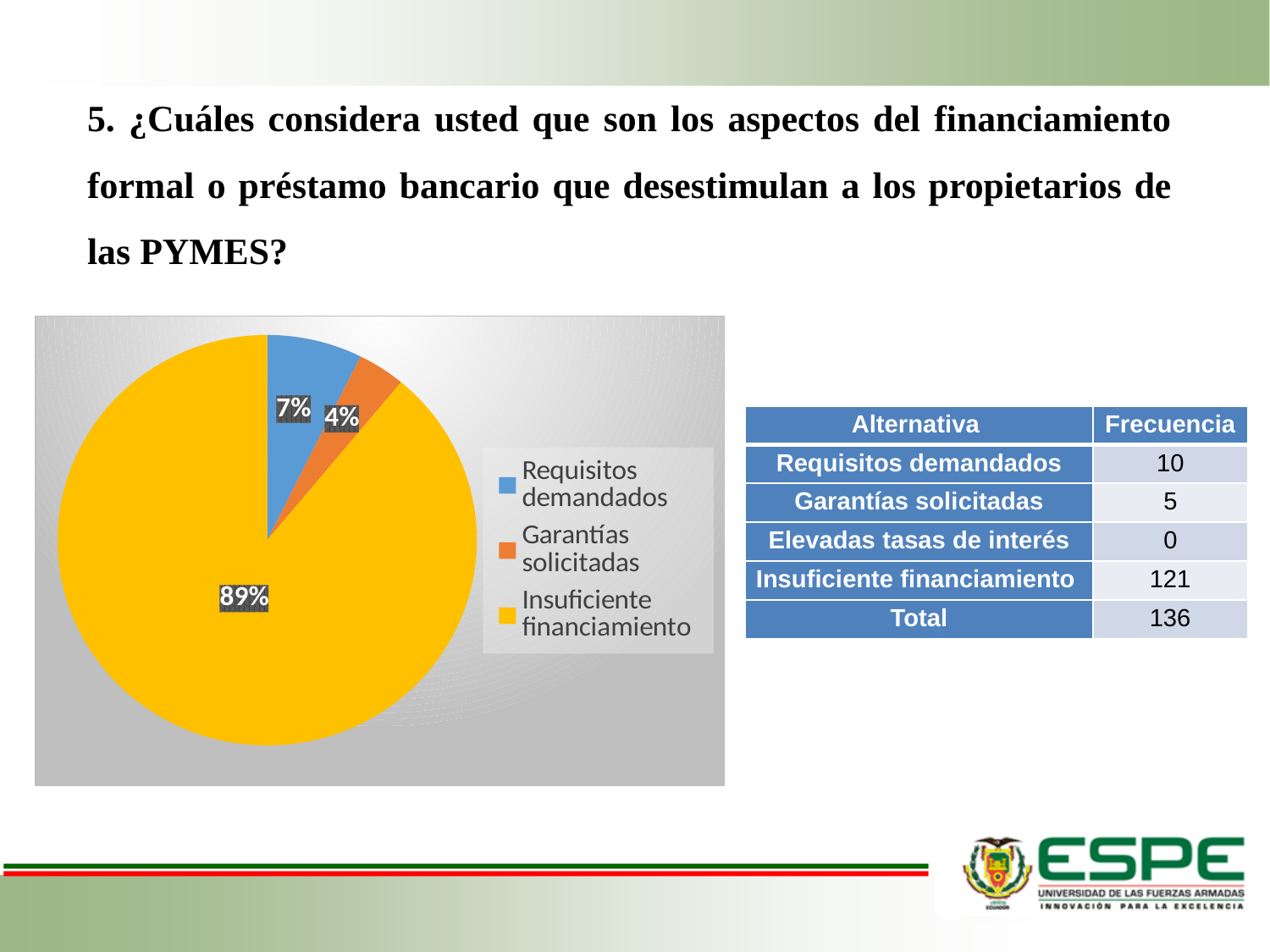
What percentage of the pie chart corresponds to Garantías solicitadas? 4% Which category has the smallest slice in the pie chart? Garantías solicitadas What is the difference in percentage points between Requisitos demandados and Garantías solicitadas in the pie chart? 3 What type of chart is shown on the slide? Pie chart What is the difference in percentage points between Insuficiente financiamiento and Requisitos demandados in the pie chart? 82 How many entries does the pie chart's legend list? 3 What percentage of the pie chart corresponds to Insuficiente financiamiento? 89% What percentage of the pie chart corresponds to Requisitos demandados? 7% What colour is the Insuficiente financiamiento slice in the pie chart? Yellow Which slice is larger in the pie chart, Requisitos demandados or Garantías solicitadas? Requisitos demandados Which category has the largest slice in the pie chart? Insuficiente financiamiento How many slices does the pie chart have? 3